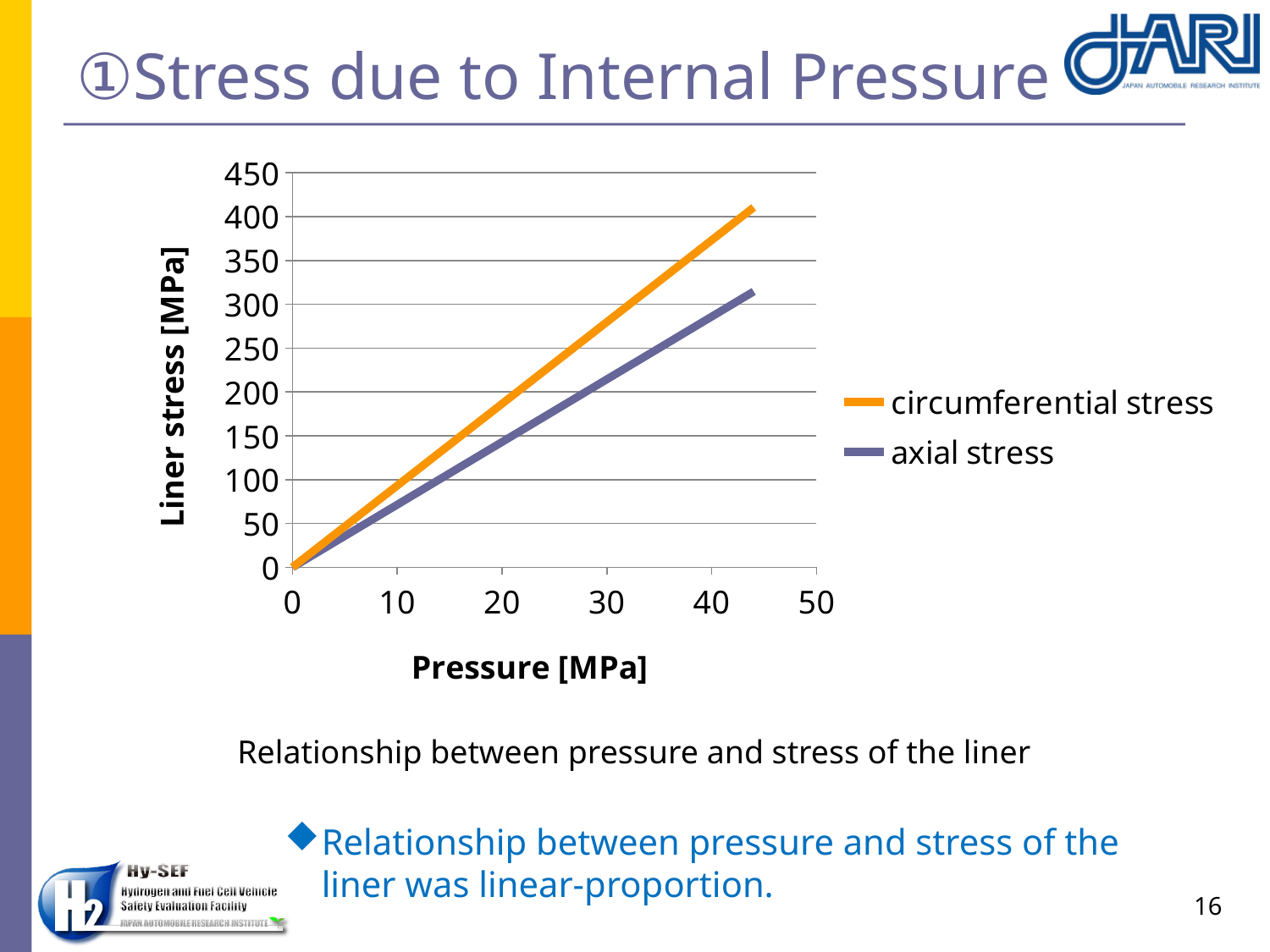
At a pressure of 40 MPa, is the circumferential stress greater or less than 350 MPa? greater What is the title of the vertical axis? Liner stress [MPa] What kind of chart is shown on the slide? line chart At a pressure of 20 MPa, is the circumferential stress greater or less than 150 MPa? greater At a pressure of 40 MPa, which series has the higher liner stress, circumferential stress or axial stress? circumferential stress Does the circumferential stress rise or fall as pressure increases? rise How many series does the legend list? 2 At a pressure of 20 MPa, is the axial stress greater or less than 100 MPa? greater Does the axial stress rise or fall as pressure increases? rise Which series is plotted in orange? circumferential stress